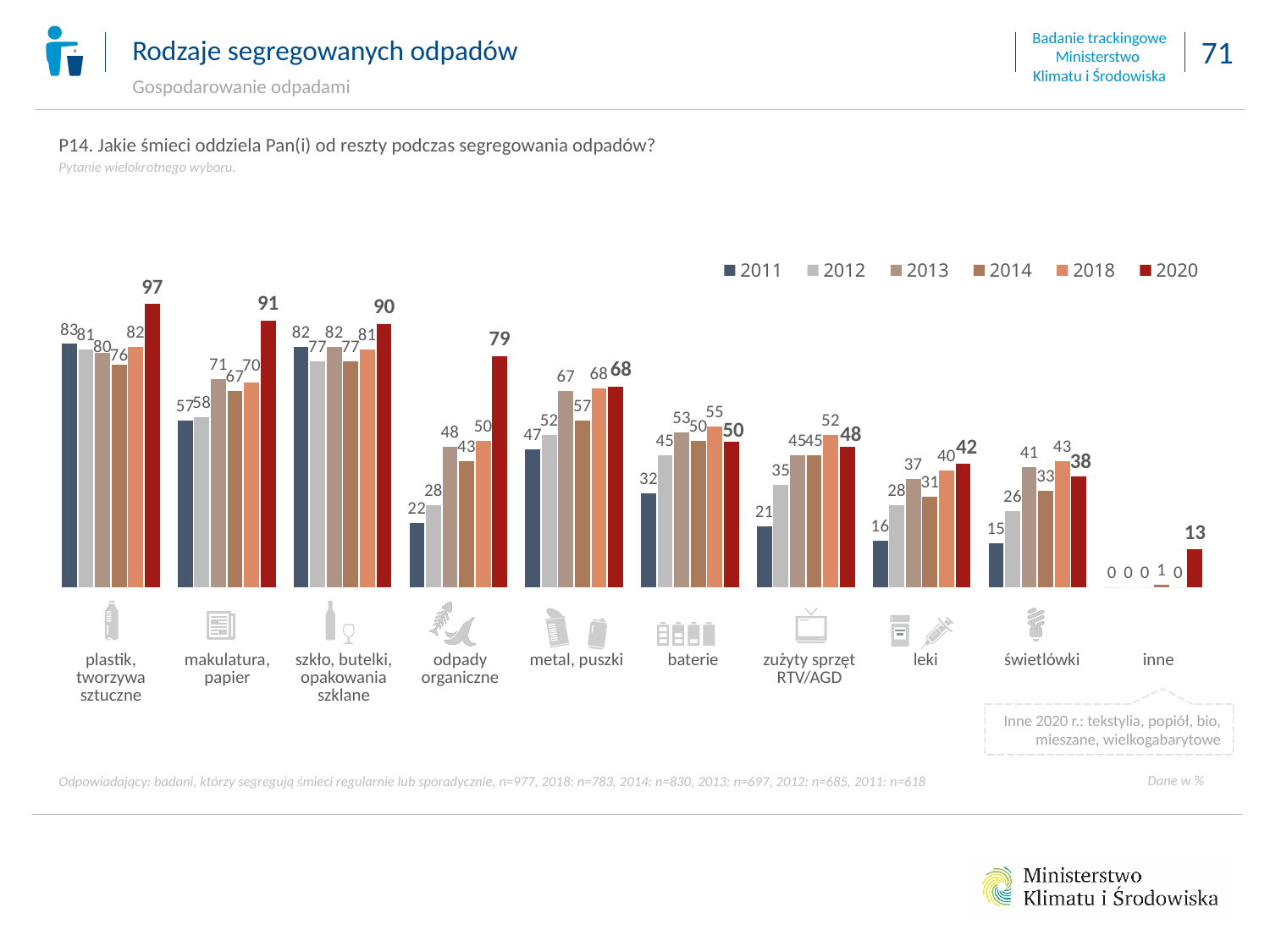
What is the value for inne in 2014? 1 How many series does the legend list? 6 What is the difference between the 2020 and 2011 values for odpady organiczne? 57 What is the value for plastik, tworzywa sztuczne in 2020? 97 Which category has the highest value in 2020? plastik, tworzywa sztuczne What is the value for leki in 2018? 40 Which year is shown in dark red in the legend? 2020 How many waste categories are shown on the chart? 10 Which category has the lowest value in 2011? inne Which is larger for świetlówki: the 2018 value or the 2020 value? 2018 What type of chart is shown on the slide? bar chart What is the value for odpady organiczne in 2011? 22